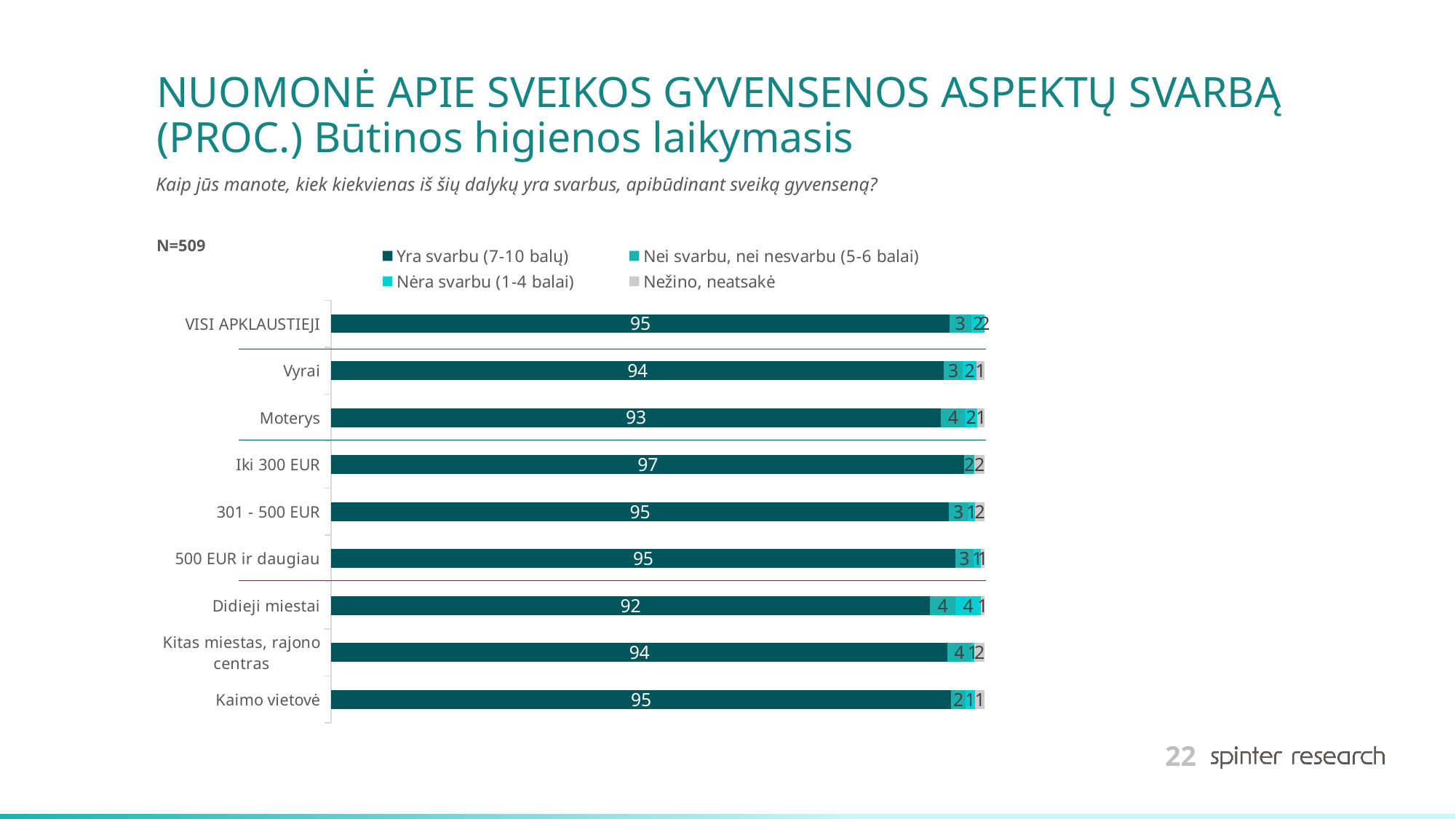
Which has a larger "Yra svarbu (7-10 balų)" value, Vyrai or Moterys? Vyrai How many series does the legend list? 4 What kind of chart is shown on the slide? Stacked bar chart Which category has the lowest value for "Yra svarbu (7-10 balų)"? Didieji miestai What is the value of "Yra svarbu (7-10 balų)" for VISI APKLAUSTIEJI? 95 Which category has the highest value for "Yra svarbu (7-10 balų)"? Iki 300 EUR What is the value of "Yra svarbu (7-10 balų)" for Kitas miestas, rajono centras? 94 What sample size (N) is stated on the slide? N=509 What is the value of "Yra svarbu (7-10 balų)" for Moterys? 93 What is the value of "Nei svarbu, nei nesvarbu (5-6 balai)" for Moterys? 4 How many categories are shown on the chart? 9 What is the difference between the "Yra svarbu (7-10 balų)" values for Iki 300 EUR and Didieji miestai? 5